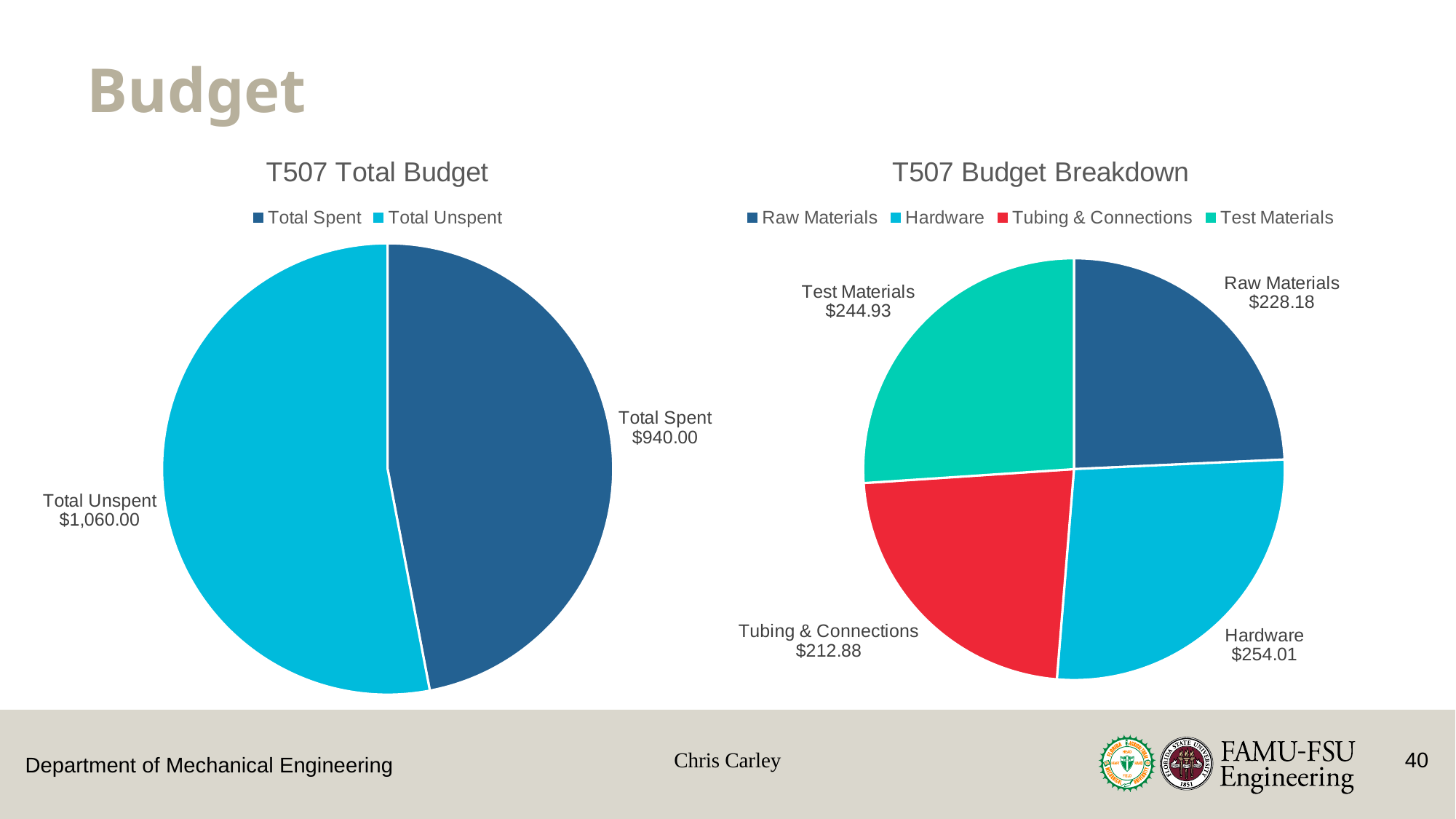
In the T507 Budget Breakdown chart, what is the difference between Hardware and Tubing & Connections? $41.13 In the T507 Budget Breakdown chart, what is the value for Tubing & Connections? $212.88 In the T507 Budget Breakdown chart, which category has the highest value? Hardware In the T507 Budget Breakdown chart, which is larger: Test Materials or Raw Materials? Test Materials How many categories does the T507 Budget Breakdown chart show? 4 In the T507 Total Budget chart, what is the value for Total Unspent? $1,060.00 In the T507 Budget Breakdown chart, which category has the lowest value? Tubing & Connections What kind of chart is the T507 Total Budget chart? Pie chart In the T507 Total Budget chart, what is the value for Total Spent? $940.00 In the T507 Total Budget chart, what share of the pie is Total Spent? 47% In the T507 Total Budget chart, what is the difference between Total Unspent and Total Spent? $120.00 In the T507 Budget Breakdown chart, what is the value for Hardware? $254.01